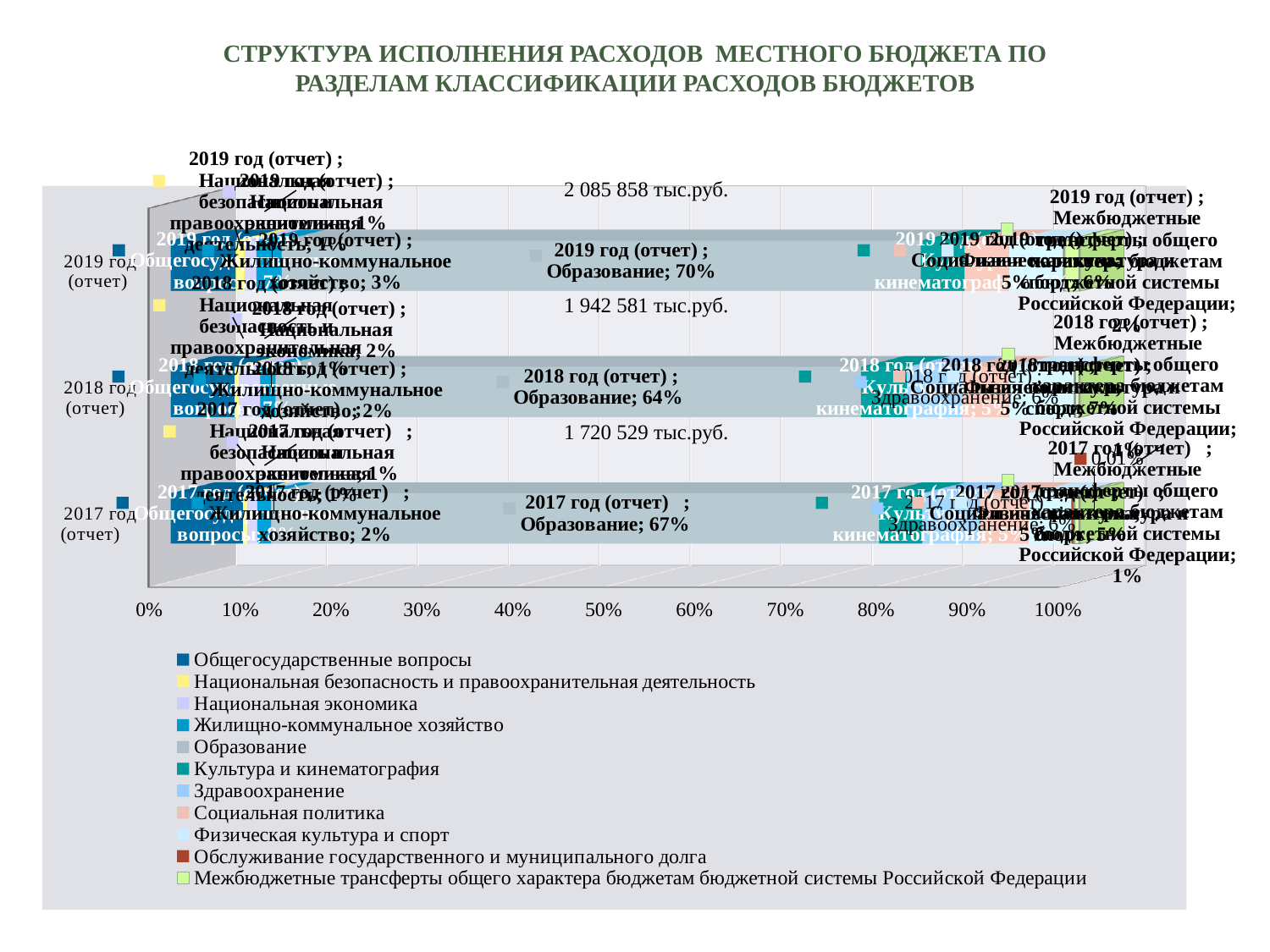
How many series does the legend list? 11 What total amount is labelled above the 2019 год (отчет) bar? 2 085 858 тыс.руб. What is the title of the chart? СТРУКТУРА ИСПОЛНЕНИЯ РАСХОДОВ МЕСТНОГО БЮДЖЕТА ПО РАЗДЕЛАМ КЛАССИФИКАЦИИ РАСХОДОВ БЮДЖЕТОВ What share does Образование have in the 2017 год (отчет) bar? 67% In which year is the share of Образование the highest? 2019 год (отчет) How many year categories are plotted on the chart? 3 What kind of chart is shown on the slide? bar chart Which year has the larger Образование share, 2018 год (отчет) or 2017 год (отчет)? 2017 год (отчет) What share does Образование have in the 2018 год (отчет) bar? 64% What share does Жилищно-коммунальное хозяйство have in the 2019 год (отчет) bar? 3% What share does Образование have in the 2019 год (отчет) bar? 70% By how many percentage points does the Образование share in 2019 год (отчет) exceed that in 2018 год (отчет)? 6